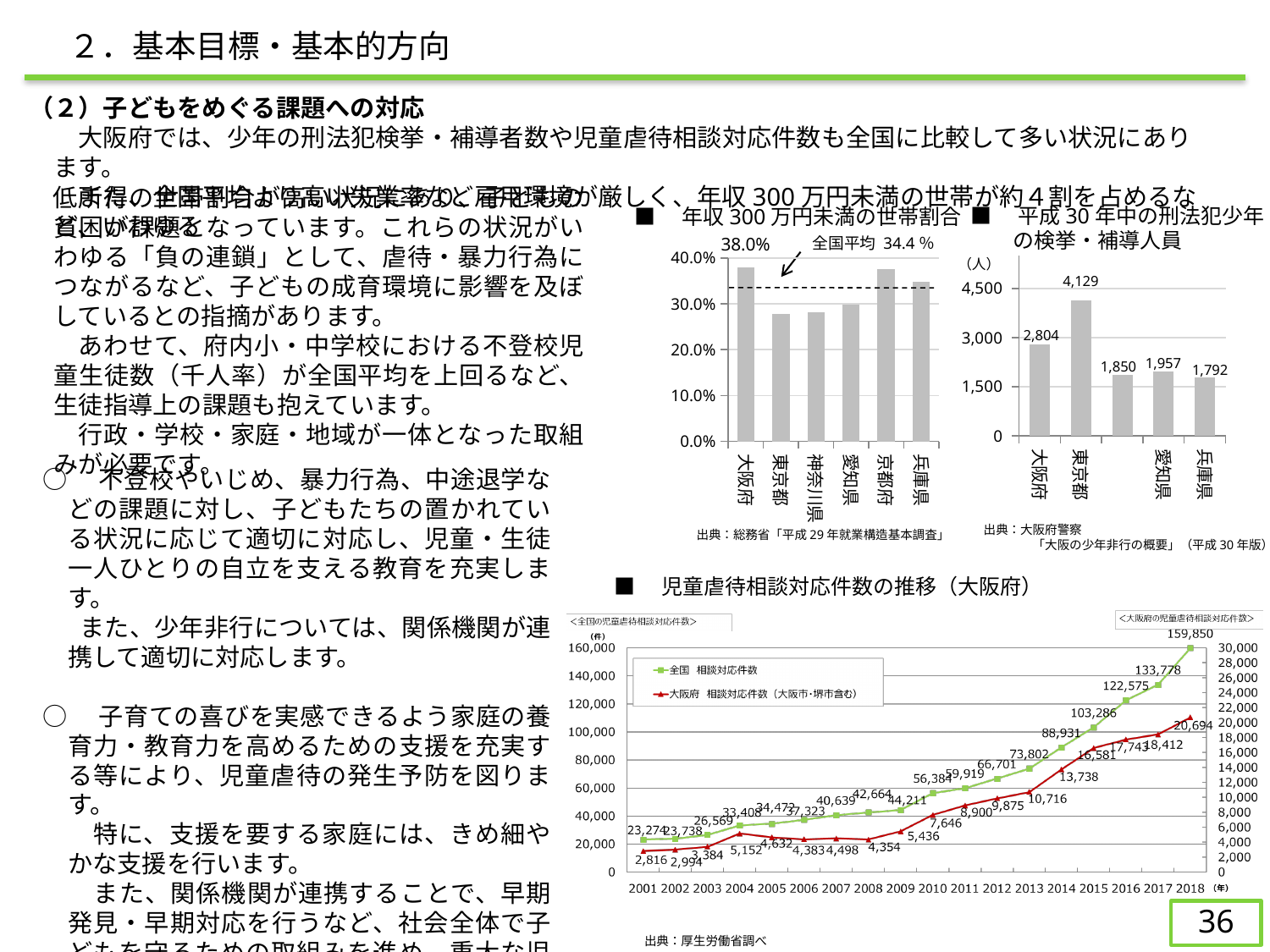
In the chart titled 年収300万円未満の世帯割合, what is the value for 大阪府? 38.0% In the chart titled 年収300万円未満の世帯割合, how many prefectures are shown on the x axis? 6 In the chart titled 平成30年中の刑法犯少年の検挙・補導人員, what is the value for 東京都? 4,129 In the chart titled 児童虐待相談対応件数の推移（大阪府）, what is the 全国 相談対応件数 value for 2018? 159,850 In the chart titled 平成30年中の刑法犯少年の検挙・補導人員, which prefecture has the highest value? 東京都 In the chart titled 児童虐待相談対応件数の推移（大阪府）, how many series does the legend list? 2 In the chart titled 平成30年中の刑法犯少年の検挙・補導人員, what is the value for 大阪府? 2,804 In the chart titled 平成30年中の刑法犯少年の検挙・補導人員, what is the difference between 東京都 and 大阪府? 1,325 In the chart titled 年収300万円未満の世帯割合, what is the 全国平均 value shown? 34.4% In the chart titled 児童虐待相談対応件数の推移（大阪府）, does the 全国 相談対応件数 series rise or fall from 2001 to 2018? rise In the chart titled 年収300万円未満の世帯割合, is the value for 東京都 greater or less than 30.0%? less In the chart titled 児童虐待相談対応件数の推移（大阪府）, what is the 大阪府 相談対応件数 value for 2018? 20,694